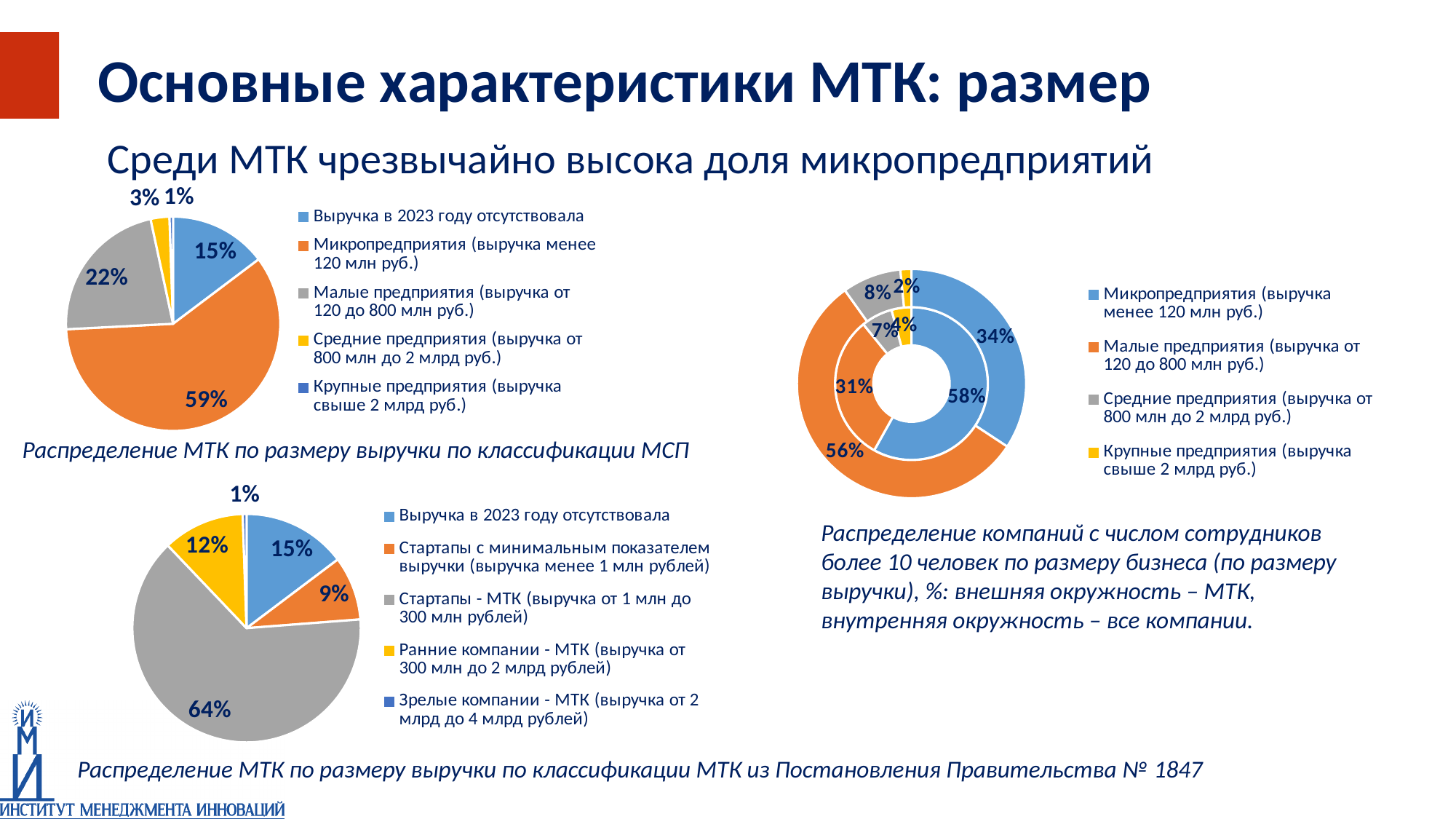
How many categories does the legend of the bottom-left pie chart list? 5 What type of chart is shown on the right side of the slide? Doughnut chart In the doughnut chart on the right, what is the difference between the share of Микропредприятия in the inner ring (все компании) and in the outer ring (МТК)? 24 percentage points In the bottom-left pie chart (classification МТК from Постановление № 1847), what share do Ранние компании - МТК have? 12% In the doughnut chart on the right, what share do Микропредприятия have in the inner ring (все компании)? 58% In the bottom-left pie chart (classification МТК from Постановление № 1847), what share do Стартапы - МТК have? 64% In the top-left pie chart (classification МСП), what is the difference between the shares of Микропредприятия and Малые предприятия? 37 percentage points In the doughnut chart on the right, what share do Малые предприятия have in the outer ring (МТК)? 56% In the top-left pie chart (Распределение МТК по размеру выручки по классификации МСП), what share do Микропредприятия have? 59% In the top-left pie chart (classification МСП), which category has the smallest share? Крупные предприятия (выручка свыше 2 млрд руб.) In the top-left pie chart (classification МСП), what share do Малые предприятия have? 22% In the bottom-left pie chart (classification МТК from Постановление № 1847), which is larger: the share of Стартапы с минимальным показателем выручки or the share of Ранние компании - МТК? Ранние компании - МТК